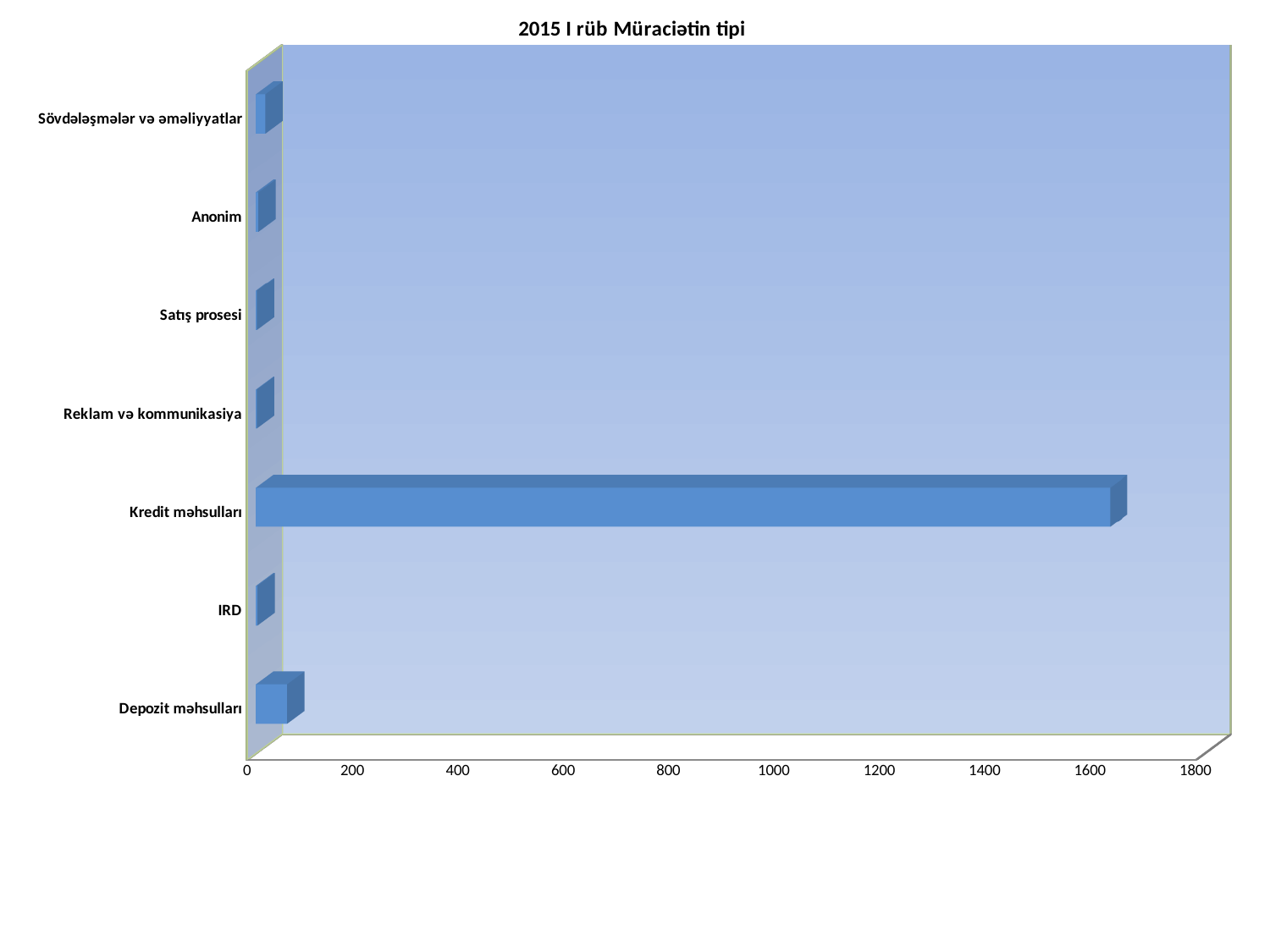
Is the value for Kredit məhsulları greater or less than 1400? greater What is the title of the chart? 2015 I rüb Müraciətin tipi Is the value for Depozit məhsulları greater or less than 200? less Which category has the highest value? Kredit məhsulları Which is larger, the value for Kredit məhsulları or the value for Depozit məhsulları? Kredit məhsulları Which is larger, the value for Kredit məhsulları or the value for Satış prosesi? Kredit məhsulları What kind of chart is shown on the slide? bar chart How many categories are shown on the chart? 7 Which is larger, the value for Depozit məhsulları or the value for IRD? Depozit məhsulları Is the value for Anonim greater or less than 200? less What is the highest value shown on the horizontal axis? 1800